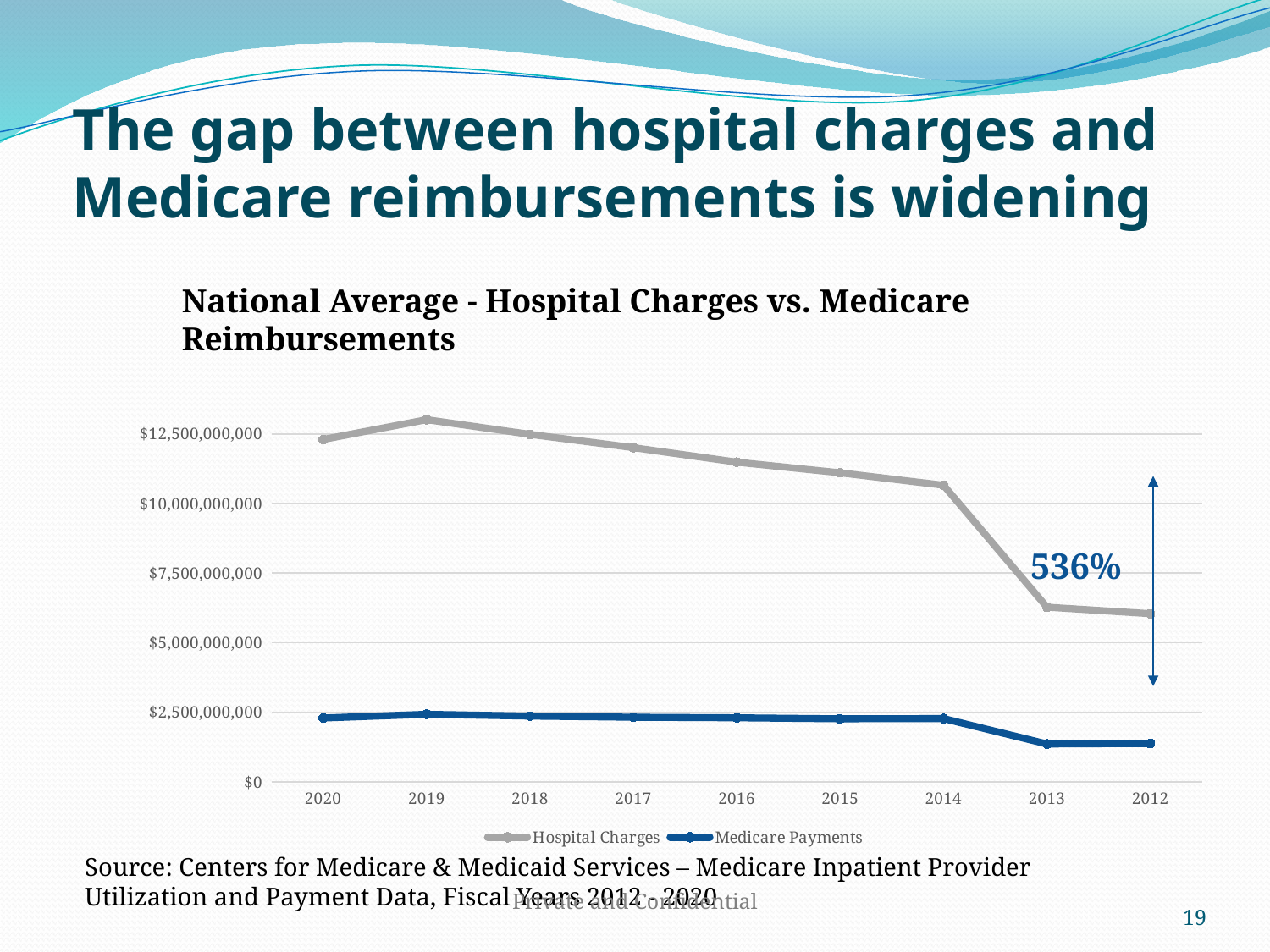
What percentage is annotated next to the arrow on the right side of the chart? 536% Is the Hospital Charges value for 2020 greater or less than $10,000,000,000? greater Is the Medicare Payments value for 2012 greater or less than $2,500,000,000? less Which is larger, the Medicare Payments value for 2019 or for 2013? 2019 Is the Hospital Charges value for 2019 greater or less than $12,500,000,000? greater How many series does the legend list? 2 Moving from left to right along the x axis (2020 to 2012), do the Hospital Charges values generally rise or fall? Fall How many years are plotted along the x axis? 9 In which year is the Hospital Charges value highest? 2019 What kind of chart is shown on the slide? Line chart Which is larger, the Hospital Charges value for 2020 or for 2013? 2020